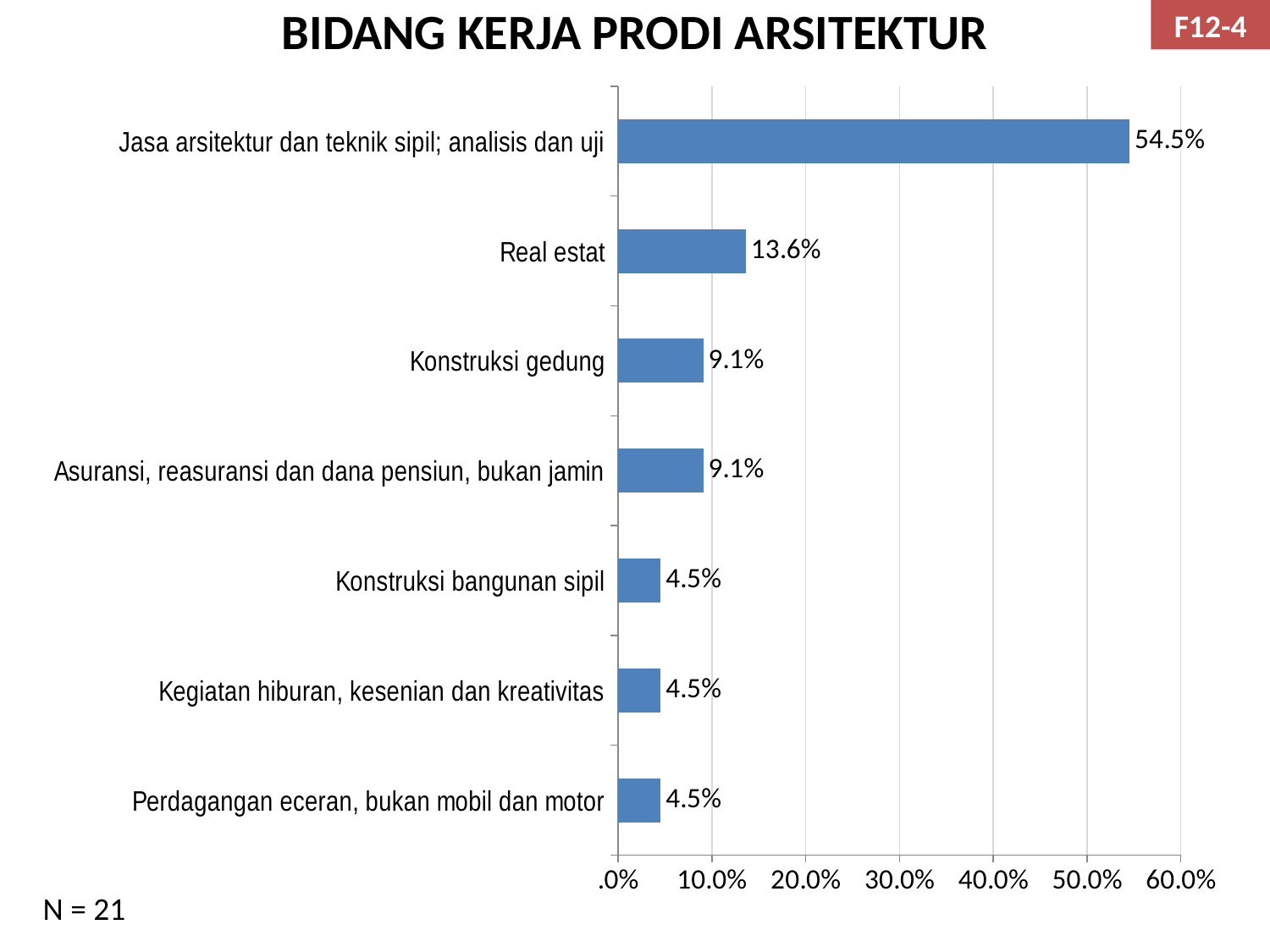
What is the title of the chart? BIDANG KERJA PRODI ARSITEKTUR What is the difference between the values for Real estat and Konstruksi gedung? 4.5% Is the value for Jasa arsitektur dan teknik sipil; analisis dan uji greater or less than 50.0%? greater What is the value for Kegiatan hiburan, kesenian dan kreativitas? 4.5% Which is larger, the value for Real estat or the value for Konstruksi bangunan sipil? Real estat What is the value for Jasa arsitektur dan teknik sipil; analisis dan uji? 54.5% How many categories are shown in the chart? 7 Which category has the highest value? Jasa arsitektur dan teknik sipil; analisis dan uji What kind of chart is shown on the slide? bar chart What is the value for Konstruksi gedung? 9.1% What is the difference between the values for Jasa arsitektur dan teknik sipil; analisis dan uji and Real estat? 40.9% What is the value for Real estat? 13.6%